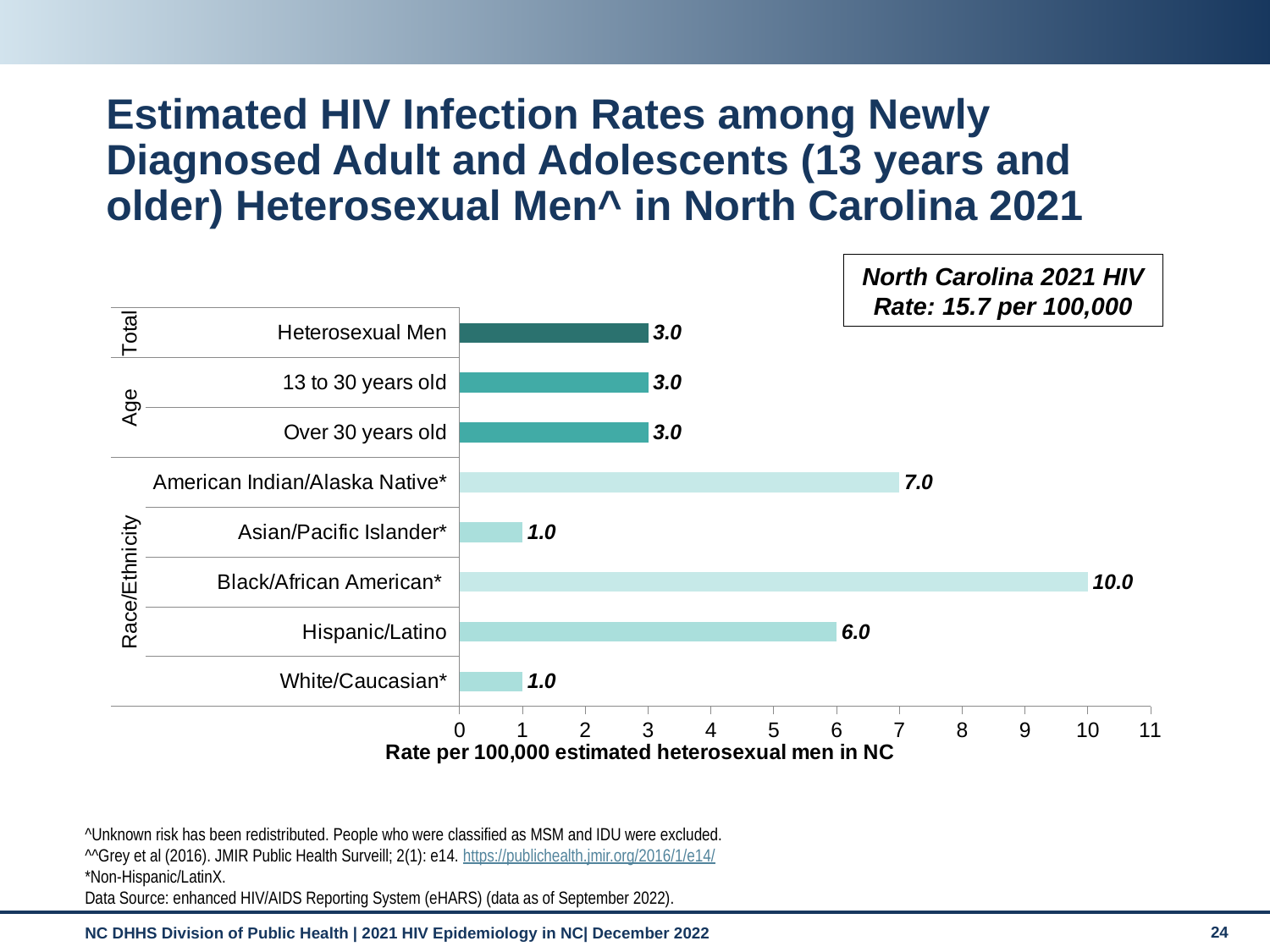
What is the rate for Hispanic/Latino heterosexual men? 6.0 Which race/ethnicity category has the highest rate? Black/African American* What is the x-axis title of the chart? Rate per 100,000 estimated heterosexual men in NC What is the estimated HIV infection rate for Black/African American* heterosexual men? 10.0 Which has a higher rate, American Indian/Alaska Native* or Hispanic/Latino? American Indian/Alaska Native* What is the difference between the rates for American Indian/Alaska Native* and White/Caucasian* heterosexual men? 6.0 What kind of chart is shown on the slide? Bar chart What is the rate for American Indian/Alaska Native* heterosexual men? 7.0 What is the difference between the rates for Black/African American* and Hispanic/Latino heterosexual men? 4.0 What is the North Carolina 2021 HIV rate shown in the box on the slide? 15.7 per 100,000 How many categories are plotted in the chart? 8 What is the rate for the Heterosexual Men total category? 3.0